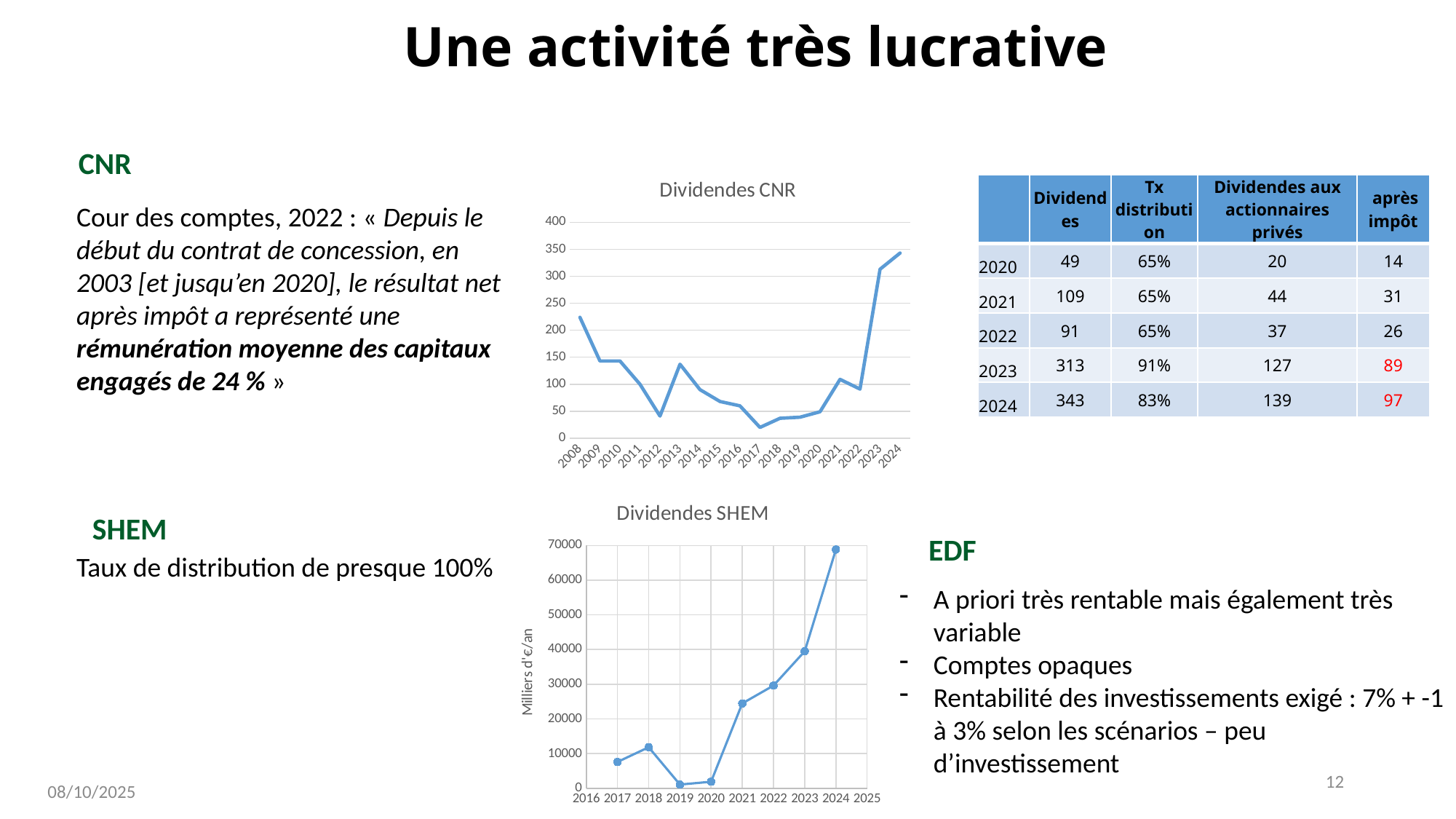
In the "Dividendes SHEM" chart, is the value for 2024 greater or less than 60000? greater What kind of chart is the "Dividendes CNR" chart? line chart In the "Dividendes CNR" chart, which is larger, the value for 2008 or the value for 2013? 2008 In the "Dividendes CNR" chart, is the value for 2012 greater or less than 50? less In the "Dividendes SHEM" chart, which year has the lowest value? 2019 In the "Dividendes CNR" chart, which year has the highest value? 2024 In the "Dividendes CNR" chart, which year has the lowest value? 2017 What is the y-axis label of the "Dividendes SHEM" chart? Milliers d'€/an In the "Dividendes SHEM" chart, which year has the highest value? 2024 In the "Dividendes SHEM" chart, do the values rise or fall from 2020 to 2024? rise In the "Dividendes CNR" chart, is the value for 2008 greater or less than 200? greater How many years are plotted on the x axis of the "Dividendes CNR" chart? 17